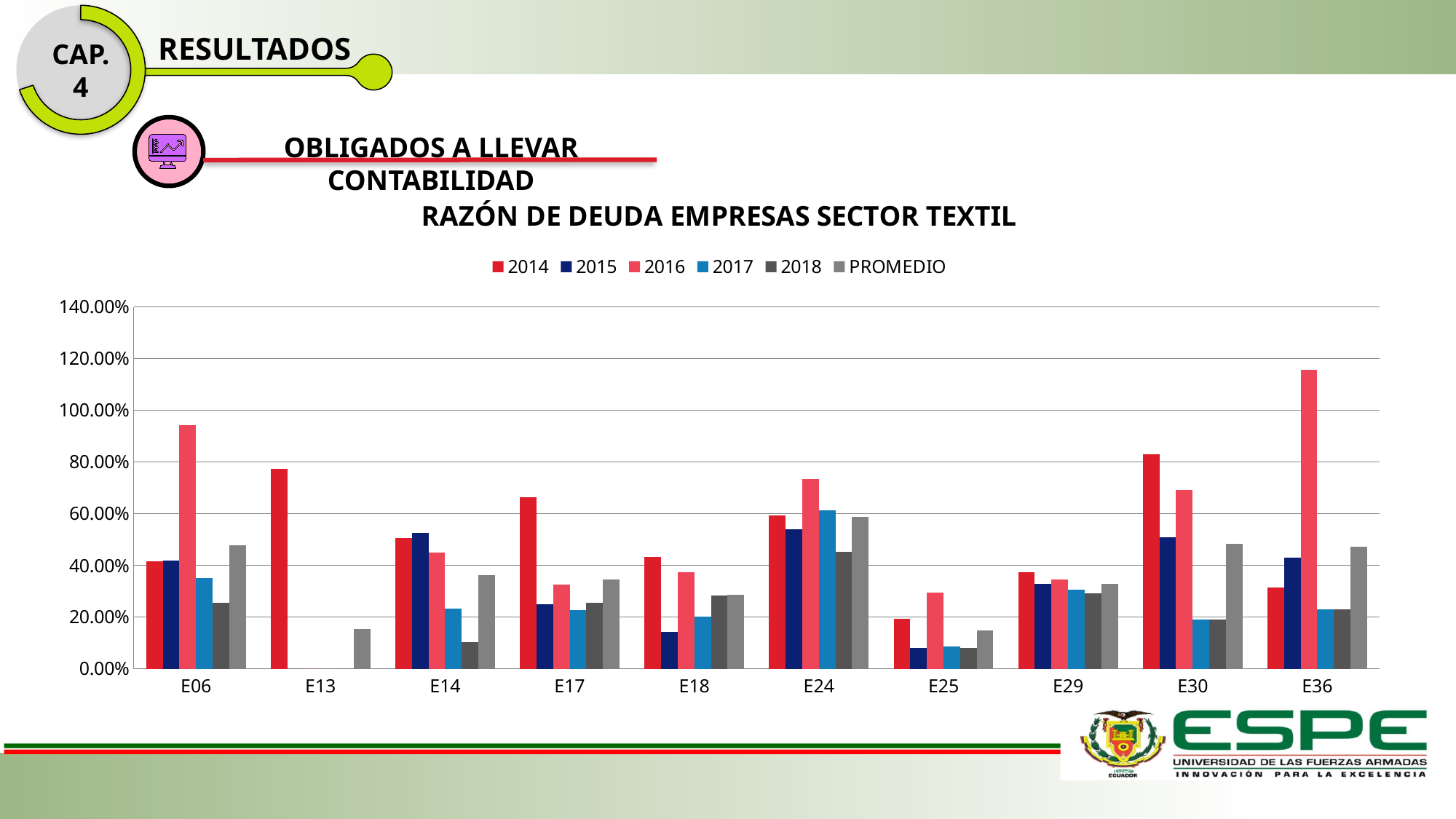
How many companies (categories) are shown on the x axis? 10 For E14, which is larger: the 2015 value or the 2017 value? 2015 Is the 2016 value for E06 greater or less than 80.00%? greater Which company has the highest 2016 value? E36 Which company has the highest 2014 value? E30 For E06, which is larger: the 2014 value or the 2016 value? 2016 What kind of chart is shown on the slide? bar chart Is the 2015 value for E25 greater or less than 20.00%? less Is the 2016 value for E36 greater or less than 100.00%? greater Which company has the lowest 2014 value? E25 What is the title of the chart? RAZÓN DE DEUDA EMPRESAS SECTOR TEXTIL How many series does the legend list? 6